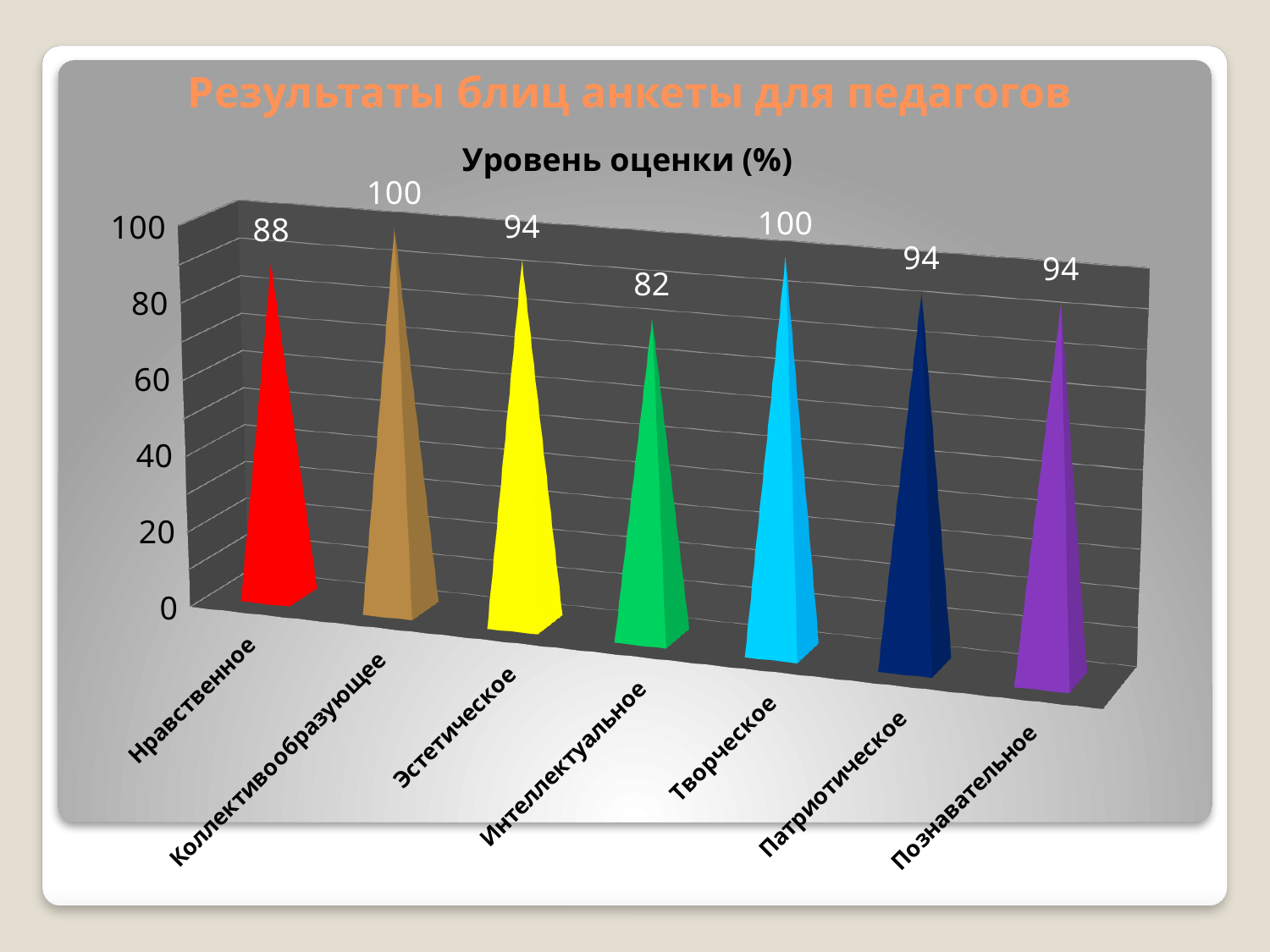
What is the title of the chart? Уровень оценки (%) What is the difference between the values for Коллективообразующее and Интеллектуальное? 18 Which categories share the highest value of 100? Коллективообразующее and Творческое Which is larger, the value for Нравственное or the value for Познавательное? Познавательное What kind of chart is shown on the slide? Bar chart What is the value for Патриотическое? 94 What is the value for Нравственное? 88 What is the value for Интеллектуальное? 82 What is the value for Творческое? 100 How many categories are shown on the chart? 7 Which category has the lowest value? Интеллектуальное What is the difference between the values for Эстетическое and Нравственное? 6